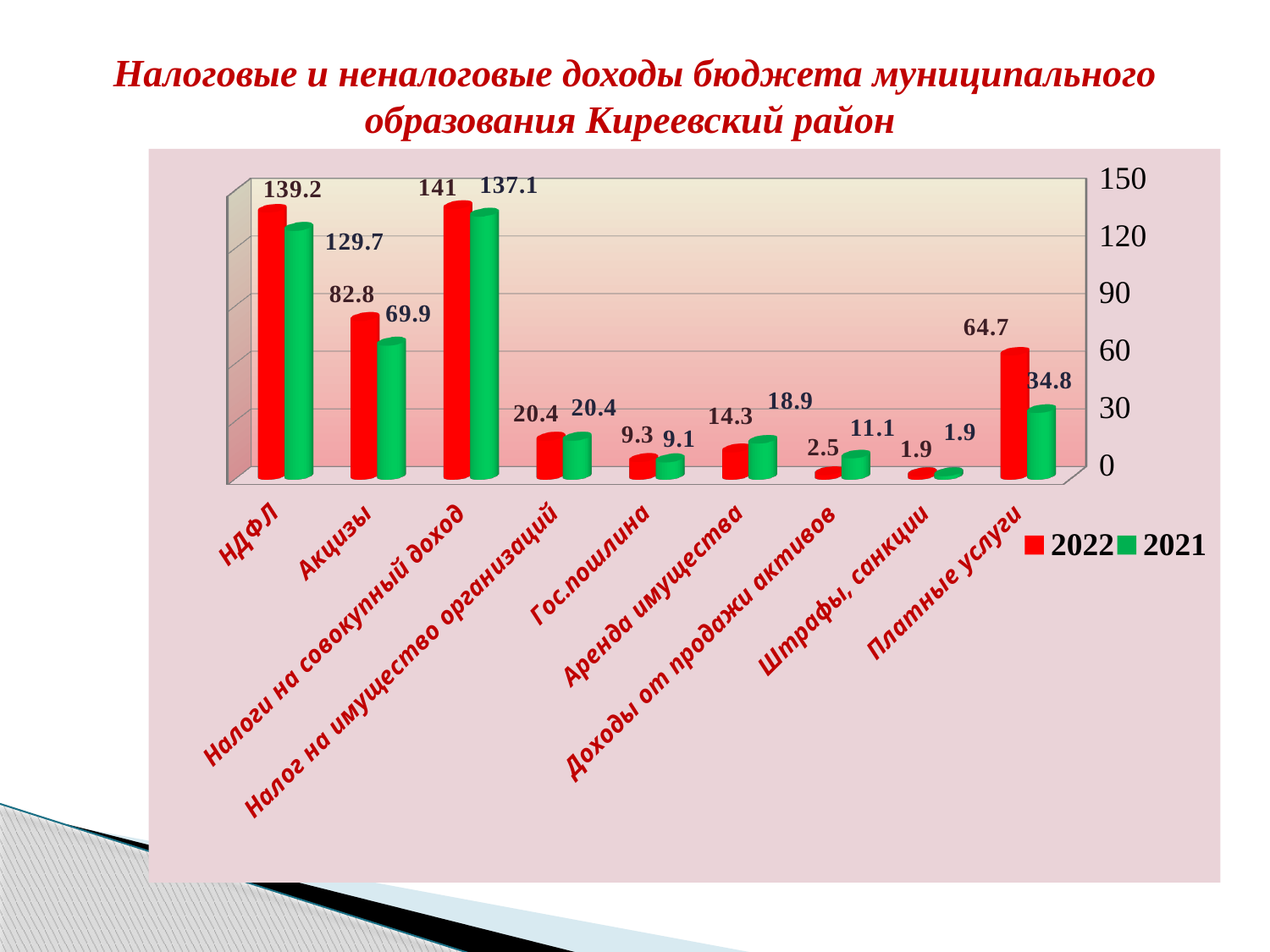
How many series does the legend list? 2 Which is larger for Аренда имущества, the 2022 value or the 2021 value? 2021 What is the 2021 value for Платные услуги? 34.8 What is the 2022 value for НДФЛ? 139.2 What is the 2022 value for Доходы от продажи активов? 2.5 How many categories are shown on the x axis? 9 Which category has the highest 2022 value? Налоги на совокупный доход Which category has the lowest 2021 value? Штрафы, санкции What is the 2021 value for Акцизы? 69.9 Is the 2022 value for Акцизы greater or less than 90? less What kind of chart is shown on the slide? bar chart What is the difference between the 2022 and 2021 values for Платные услуги? 29.9